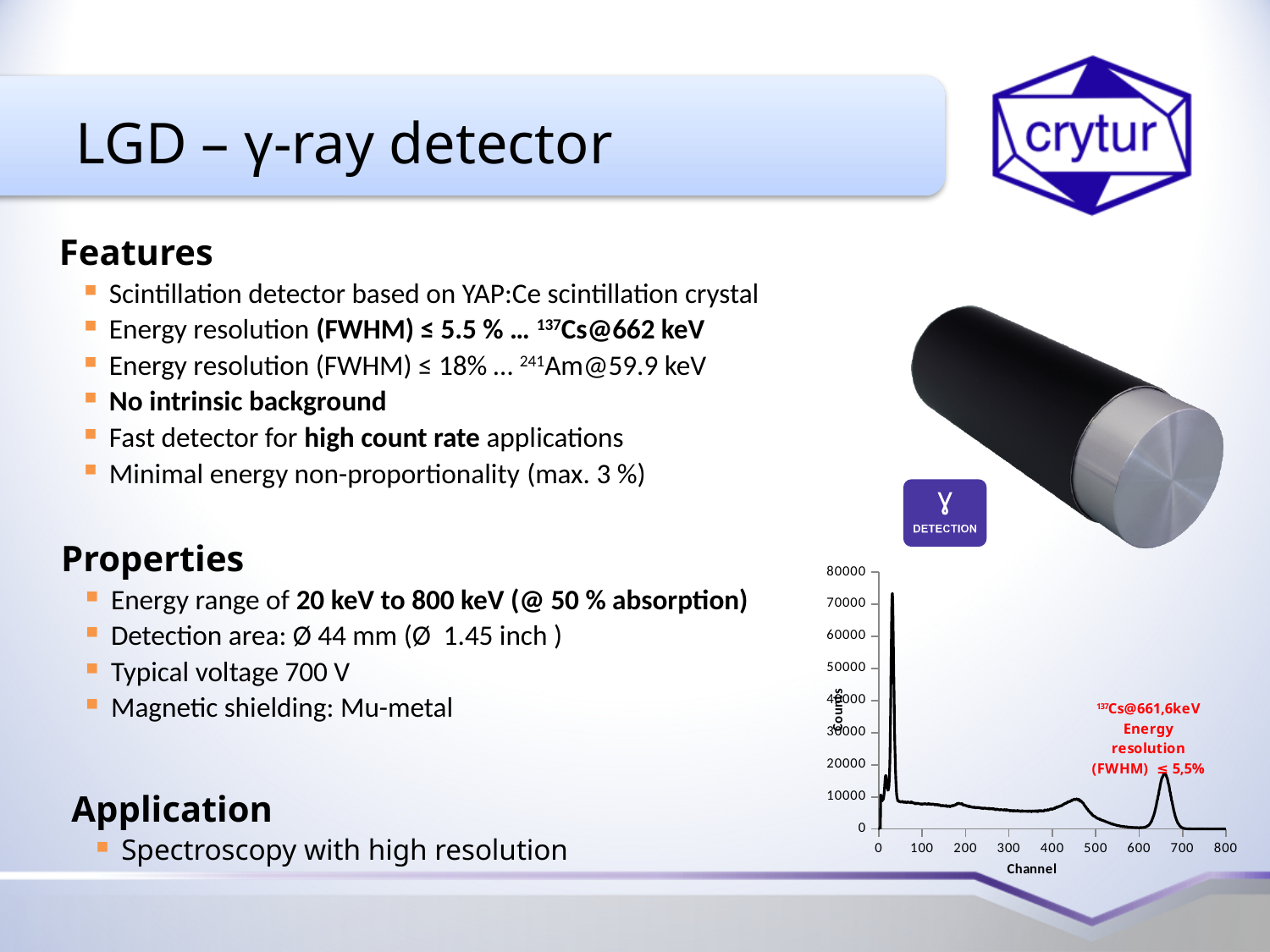
Is the tallest peak in the spectrum greater or less than 60000 counts? greater Is the small bump near channel 460 greater or less than 20000 counts? less Is the peak near channel 660 greater or less than 30000 counts? less What kind of chart is shown at the bottom right of the slide? line chart What energy resolution (FWHM) is annotated on the chart for 137Cs@661,6keV? ≤ 5,5% Which peak is taller, the one near channel 30 or the one near channel 660? the one near channel 30 What is the label of the x axis of the chart? Channel